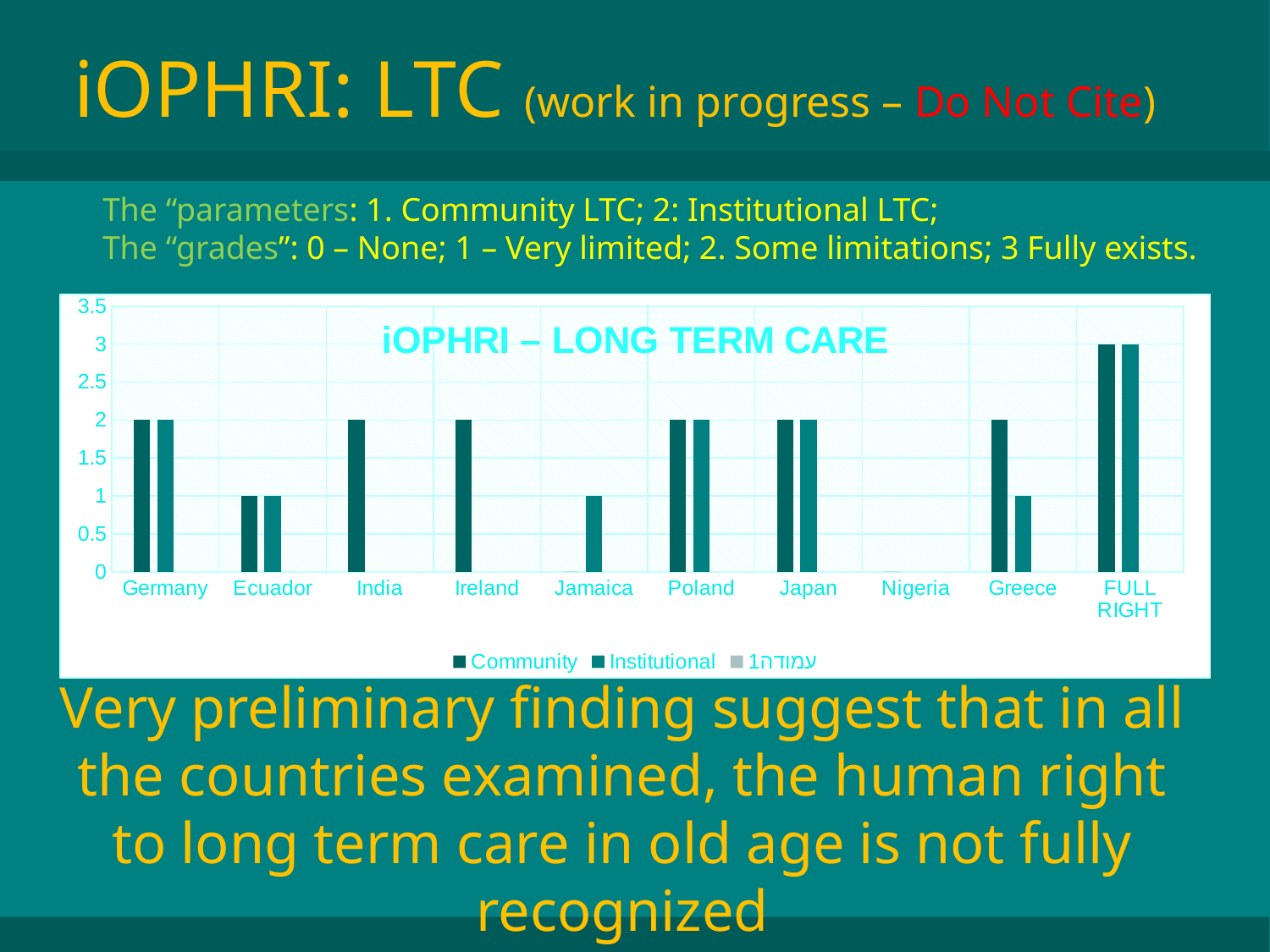
Which category shows no bars at all for either Community or Institutional? Nigeria Which is larger, the Community value for Poland or the Community value for Ecuador? Poland What is the Community value for FULL RIGHT? 3 What is the title of the chart? iOPHRI – LONG TERM CARE What is the Community value for Germany? 2 What is the difference between the Community value for Greece and the Institutional value for Greece? 1 How many countries/categories are shown on the x axis of the chart? 10 How many series does the chart legend list? 3 What type of chart is shown on the slide? bar chart Which category has the highest Institutional value? FULL RIGHT What is the Institutional value for Greece? 1 What is the Institutional value for Ecuador? 1